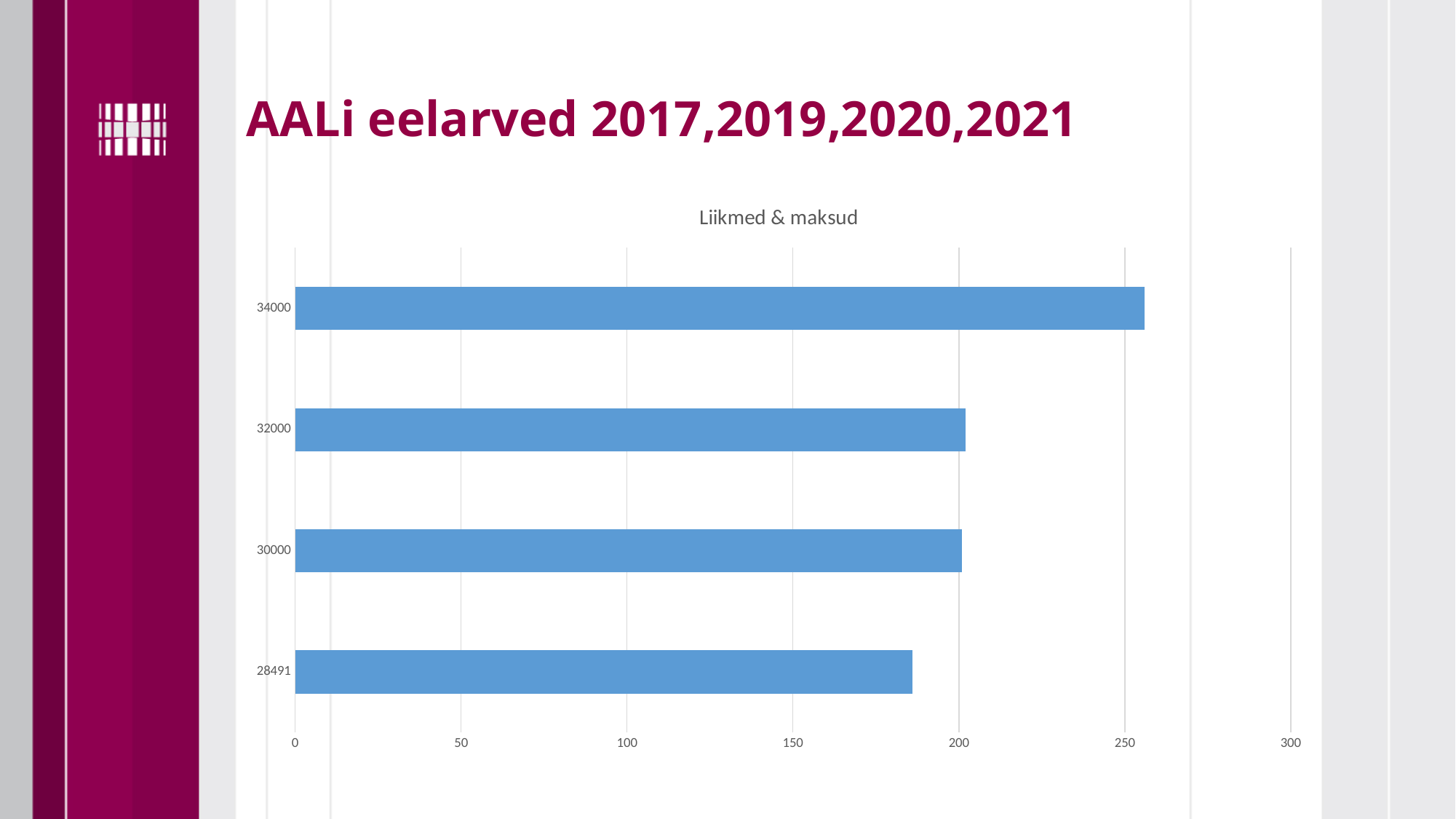
Which category has the longest bar? 34000 Is the value for 34000 greater or less than 250? greater What is the title of the chart? Liikmed & maksud What kind of chart is shown on the slide? bar chart Is the value for 28491 greater or less than 200? less Which category has the shortest bar? 28491 Which has the larger value, 34000 or 28491? 34000 What is the highest value shown on the horizontal axis? 300 Which has the larger value, 34000 or 32000? 34000 Is the value for 34000 greater or less than 300? less How many bars (categories) does the chart show? 4